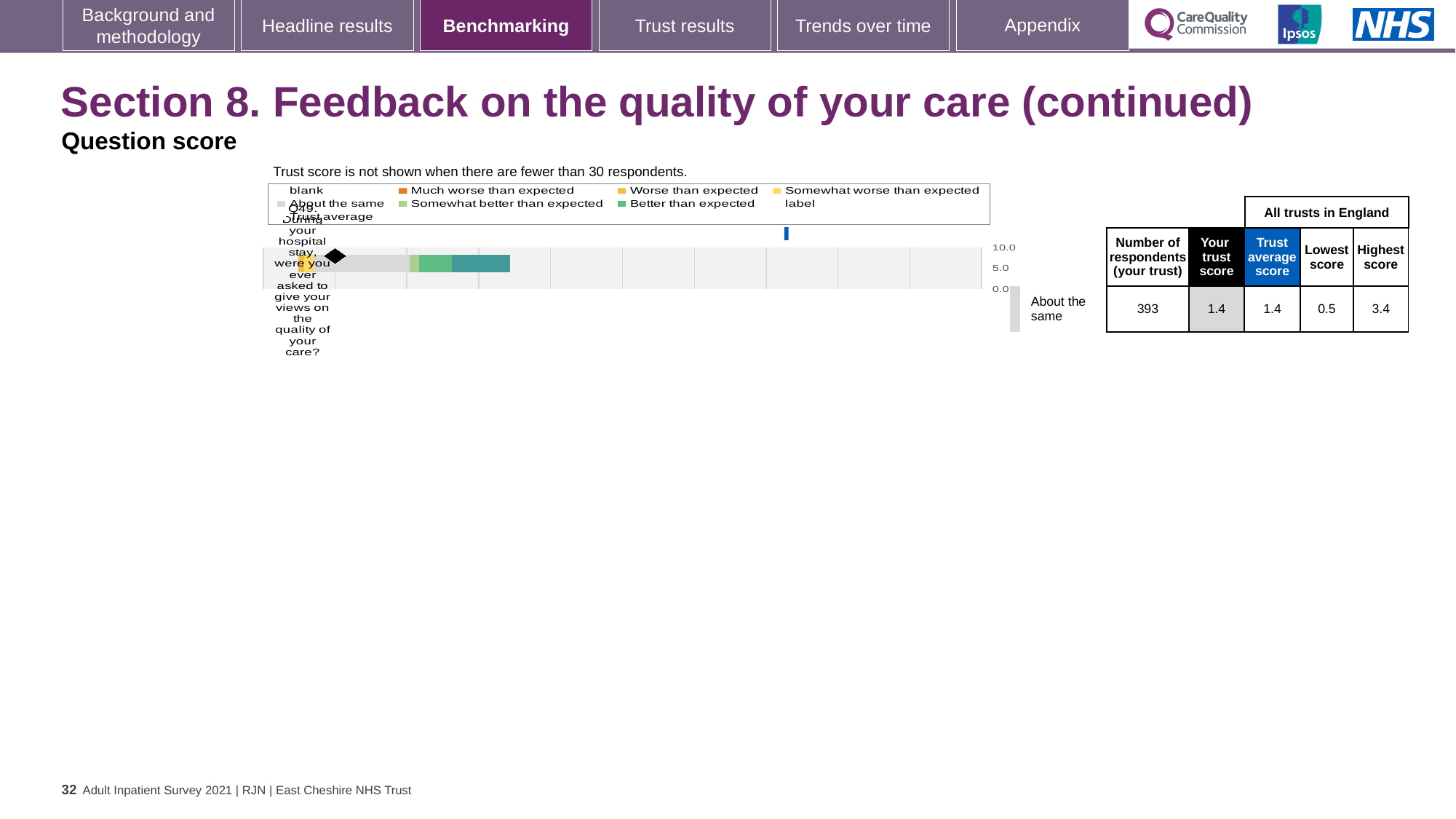
What colour represents 'Much worse than expected' in the chart legend? orange According to the table beside the chart, what is the highest score among all trusts in England for Q49? 3.4 How many respondents from your trust answered Q49, according to the table beside the chart? 393 What benchmark category label is shown to the right of the chart for Q49? About the same What kind of chart is used to show the Q49 benchmarking result? bar chart According to the table beside the chart, what is the trust average score for Q49? 1.4 According to the table beside the chart, what is the lowest score among all trusts in England for Q49? 0.5 According to the table beside the chart, what is your trust score for Q49? 1.4 Which is larger for Q49: your trust score or the highest score among all trusts in England? Highest score Is the trust score marker for Q49 on the chart greater or less than 5.0? less How many survey questions are plotted in the benchmarking chart? 1 What is the difference between the highest score and the lowest score for Q49 in the table beside the chart? 2.9